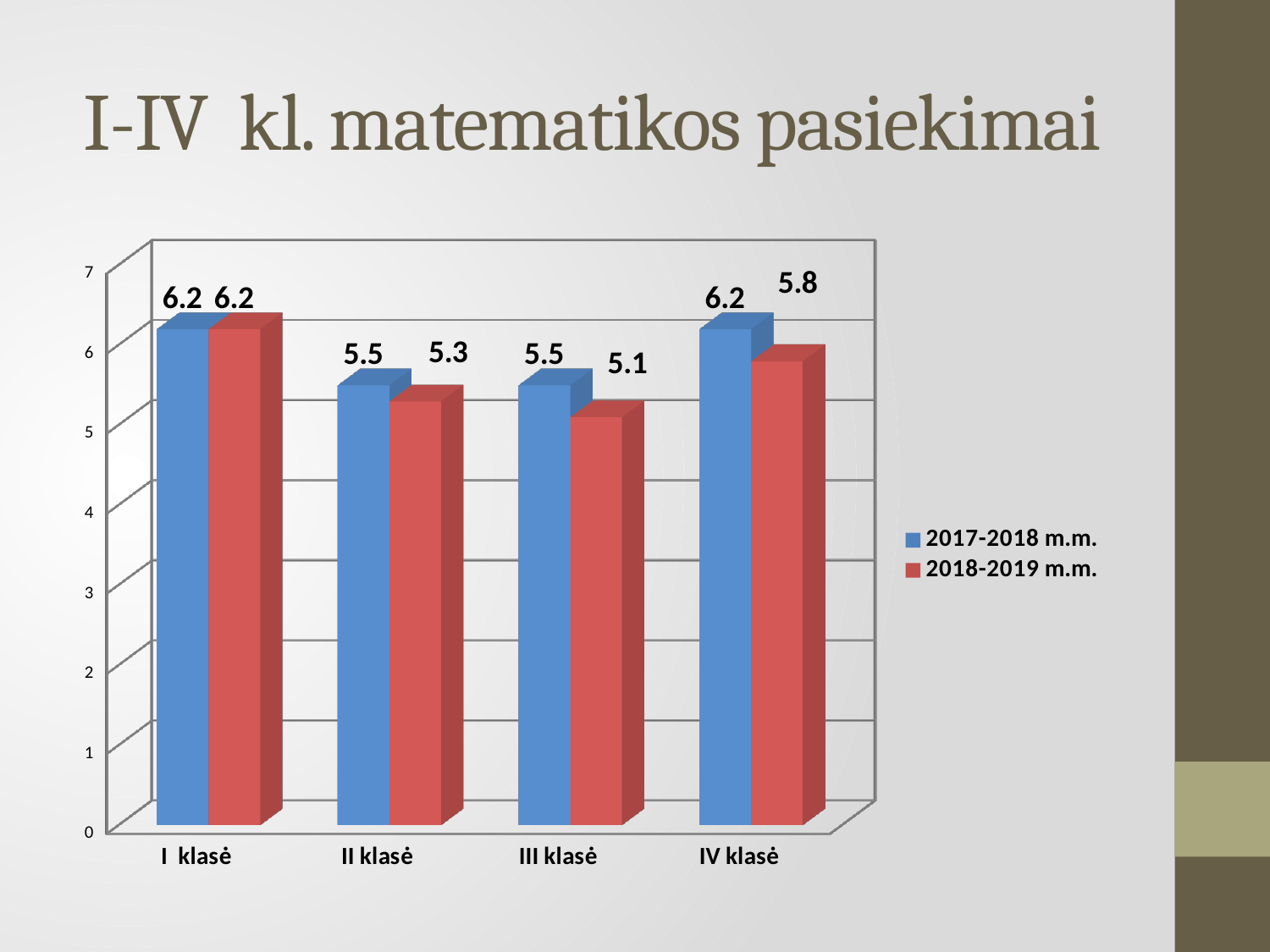
How many series does the legend list? 2 What is the value for III klasė in the 2018-2019 m.m. series? 5.1 What kind of chart is shown on the slide? Bar chart Which is larger for II klasė: the 2017-2018 m.m. value or the 2018-2019 m.m. value? 2017-2018 m.m. What is the value for IV klasė in the 2018-2019 m.m. series? 5.8 What is the title of the slide? I-IV kl. matematikos pasiekimai How many categories are shown on the x axis? 4 What is the difference between the 2017-2018 m.m. and 2018-2019 m.m. values for III klasė? 0.4 Which category has the lowest value in the 2018-2019 m.m. series? III klasė What is the value for I klasė in the 2017-2018 m.m. series? 6.2 What is the difference between the 2017-2018 m.m. and 2018-2019 m.m. values for IV klasė? 0.4 What is the value for II klasė in the 2018-2019 m.m. series? 5.3